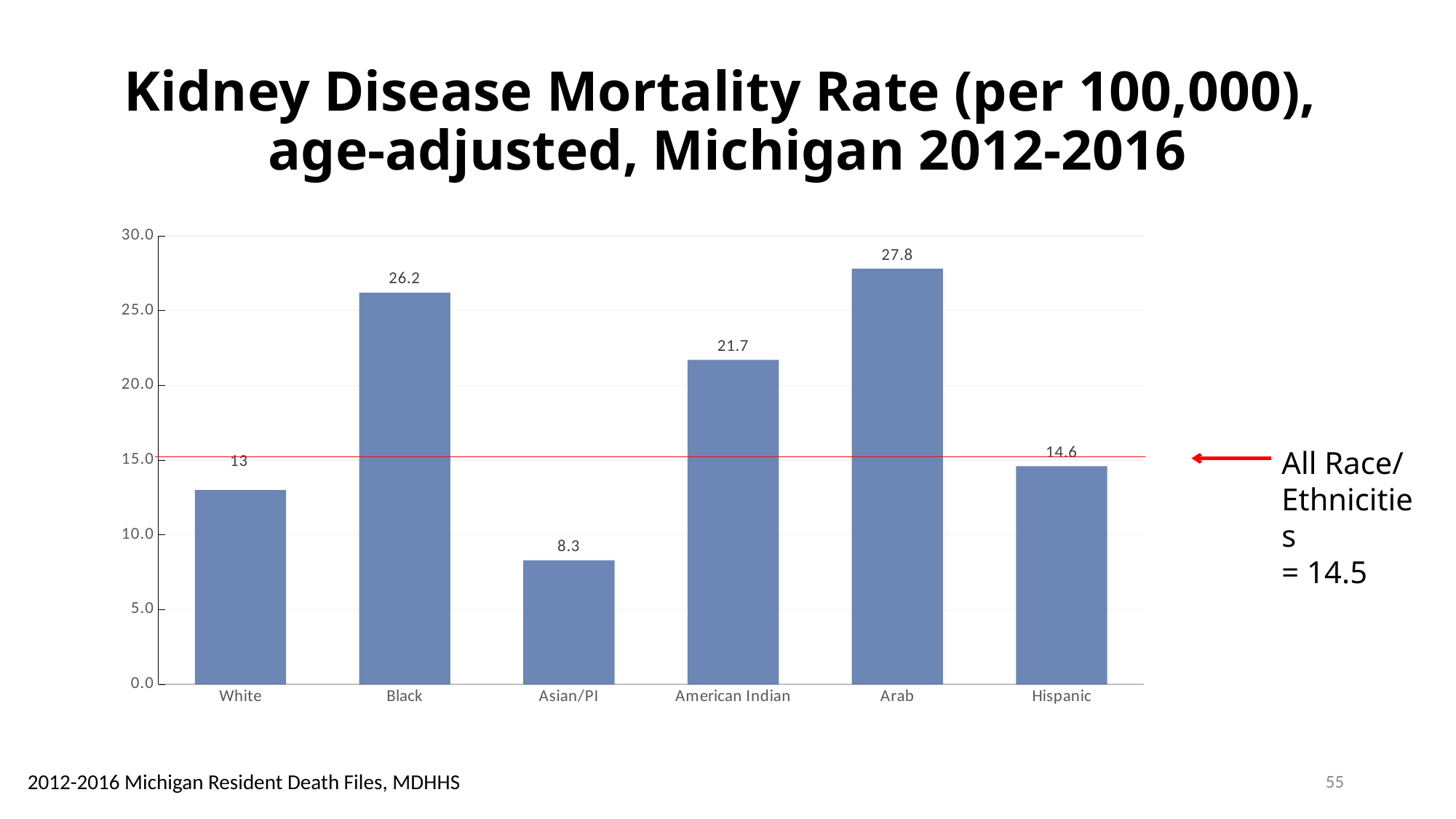
Which race/ethnicity group has the lowest kidney disease mortality rate? Asian/PI What kind of chart is shown on the slide? Bar chart What is the kidney disease mortality rate for Black residents? 26.2 What is the difference between the kidney disease mortality rates for Arab and White residents? 14.8 Which group has a higher kidney disease mortality rate, Black or American Indian? Black What is the kidney disease mortality rate for Hispanic residents? 14.6 How many race/ethnicity categories are shown on the chart? 6 What is the kidney disease mortality rate for Asian/PI residents? 8.3 What is the difference between the kidney disease mortality rates for Hispanic and Asian/PI residents? 6.3 Which race/ethnicity group has the highest kidney disease mortality rate? Arab Is the value for American Indian greater or less than 20.0? greater What is the kidney disease mortality rate for all races/ethnicities combined, as noted beside the chart? 14.5